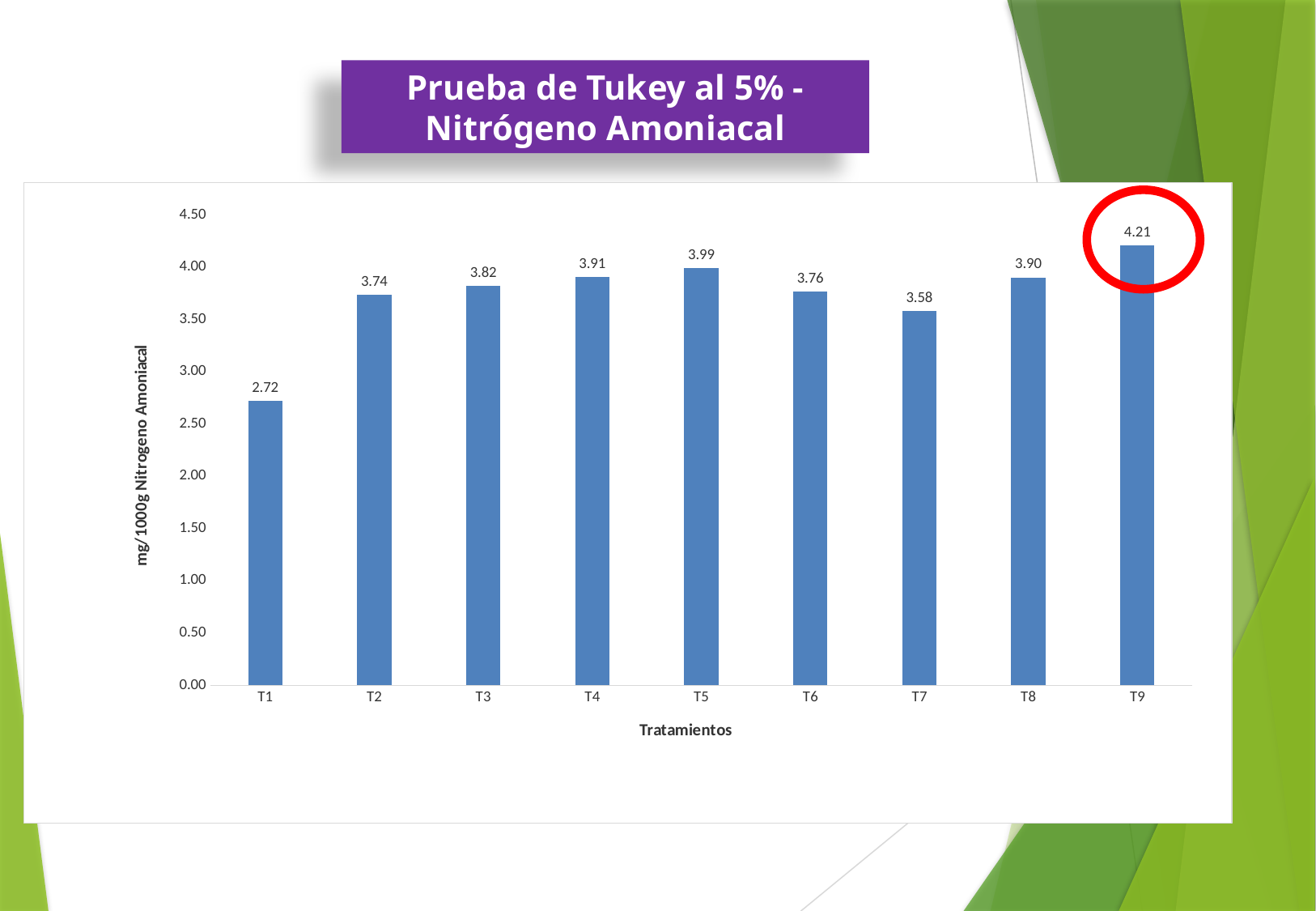
How many treatments are shown on the x axis? 9 Is the value for T2 greater or less than 3.50? greater What is the value for T1? 2.72 What kind of chart is shown on the slide? bar chart Which treatment has the lowest value? T1 What is the difference between the values for T5 and T7? 0.41 Which treatment has the highest value? T9 What is the value for T7? 3.58 What is the label of the y axis? mg/1000g Nitrogeno Amoniacal What is the value for T5? 3.99 What is the difference between the values for T9 and T1? 1.49 Which is larger, the value for T3 or the value for T6? T3